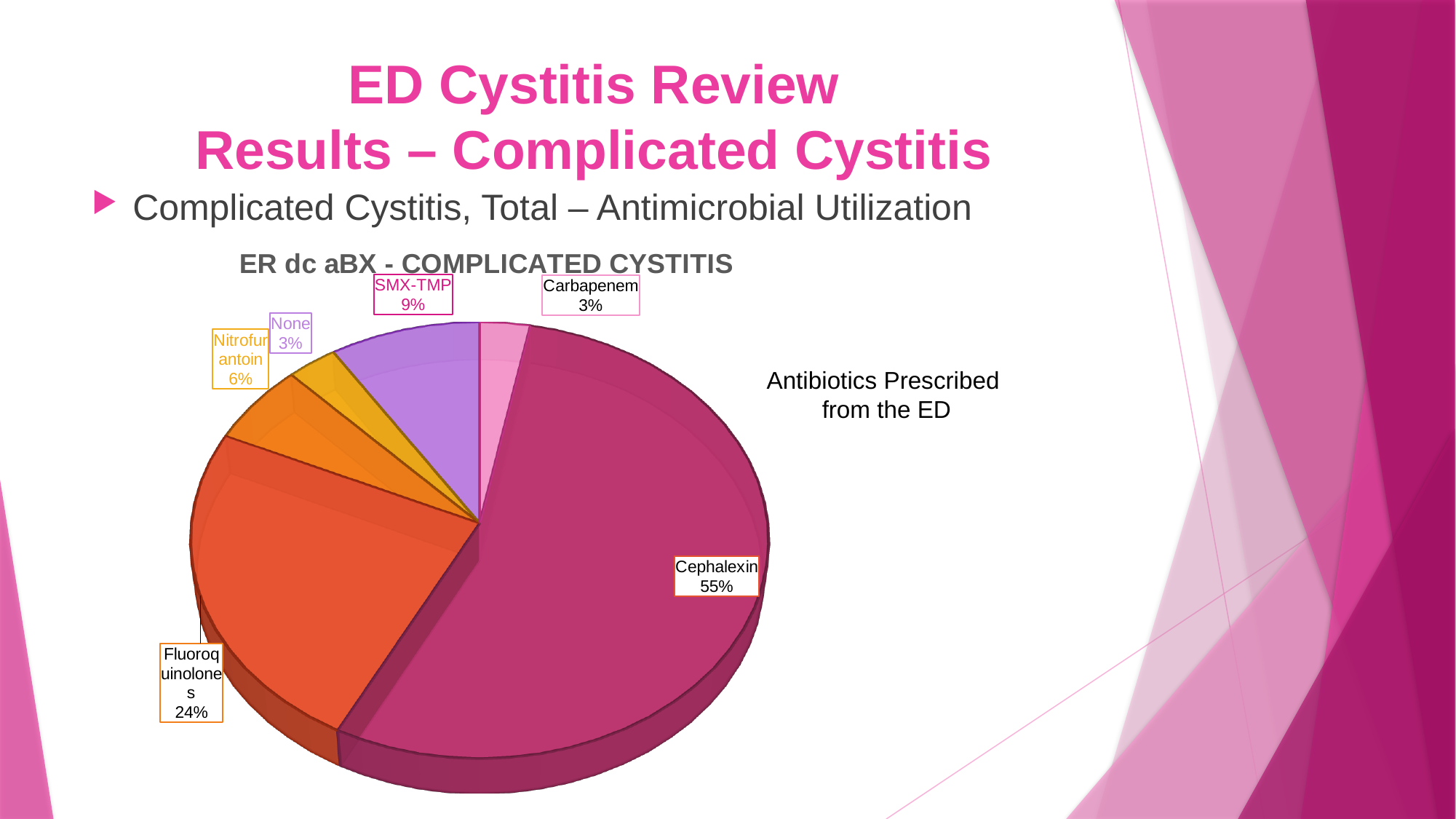
Which is larger, the share for SMX-TMP or the share for Nitrofurantoin? SMX-TMP What percentage of the pie is Nitrofurantoin? 6% What is the difference in percentage points between Cephalexin and Fluoroquinolones? 31 What percentage of the pie is Cephalexin? 55% What percentage of the pie is Carbapenem? 3% Which category has the largest share of the pie? Cephalexin What is the combined share of Carbapenem and None? 6% What is the title of the chart? ER dc aBX - COMPLICATED CYSTITIS What percentage of the pie is Fluoroquinolones? 24% What kind of chart is shown on the slide? Pie chart What percentage of the pie is SMX-TMP? 9% How many slices does the pie chart have? 6